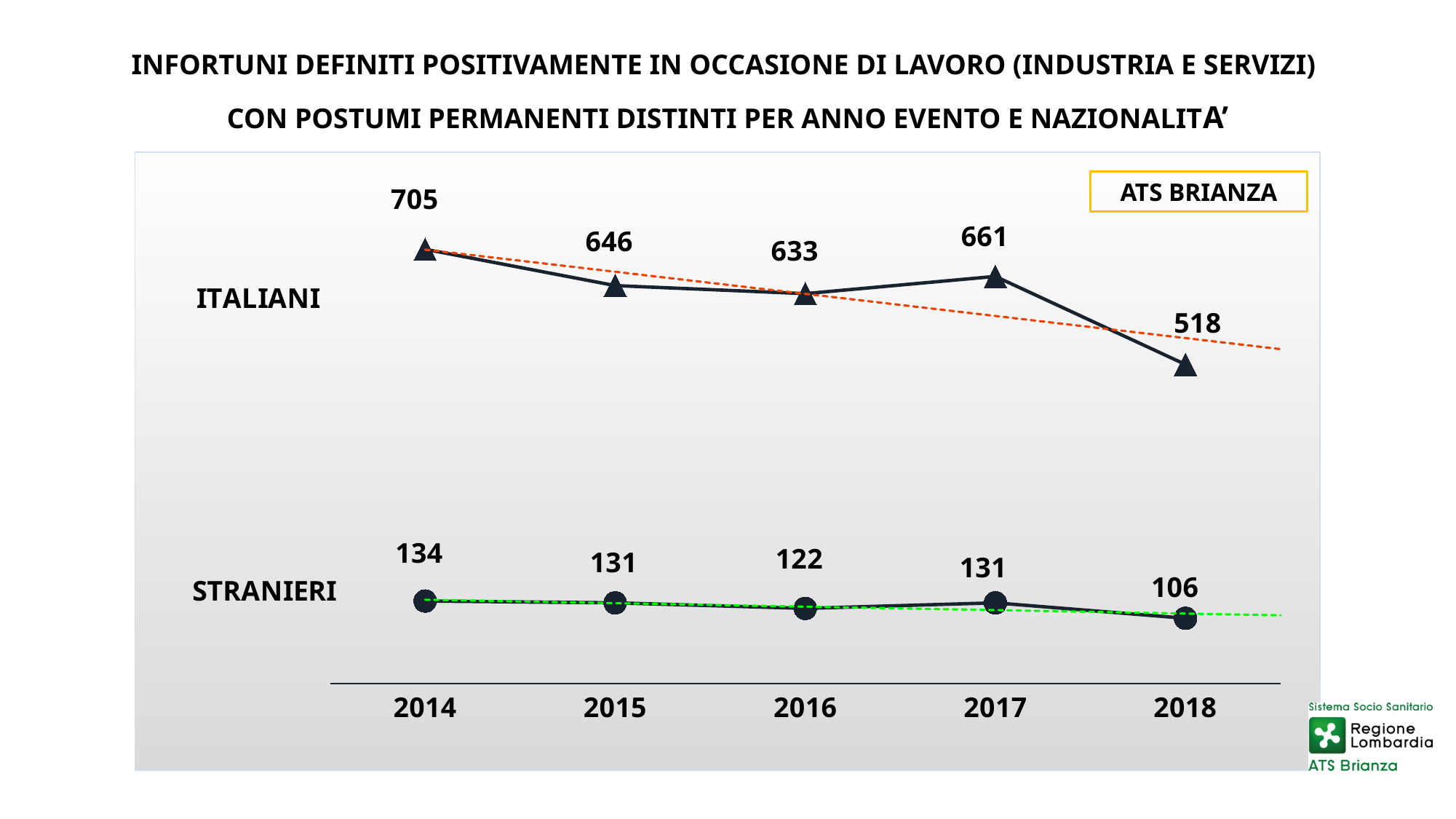
In which year is the STRANIERI value lowest? 2018 What kind of chart is shown on the slide? line chart In which year is the ITALIANI value highest? 2014 How many data series are plotted in the chart? 2 Which is larger, the ITALIANI value in 2015 or in 2016? 2015 What is the difference between the ITALIANI values in 2017 and 2018? 143 What is the value for STRANIERI in 2016? 122 How many years are shown on the x axis? 5 What is the value for ITALIANI in 2014? 705 What is the value for ITALIANI in 2018? 518 What is the difference between the STRANIERI values in 2014 and 2018? 28 Does the ITALIANI series overall rise or fall from 2014 to 2018? fall